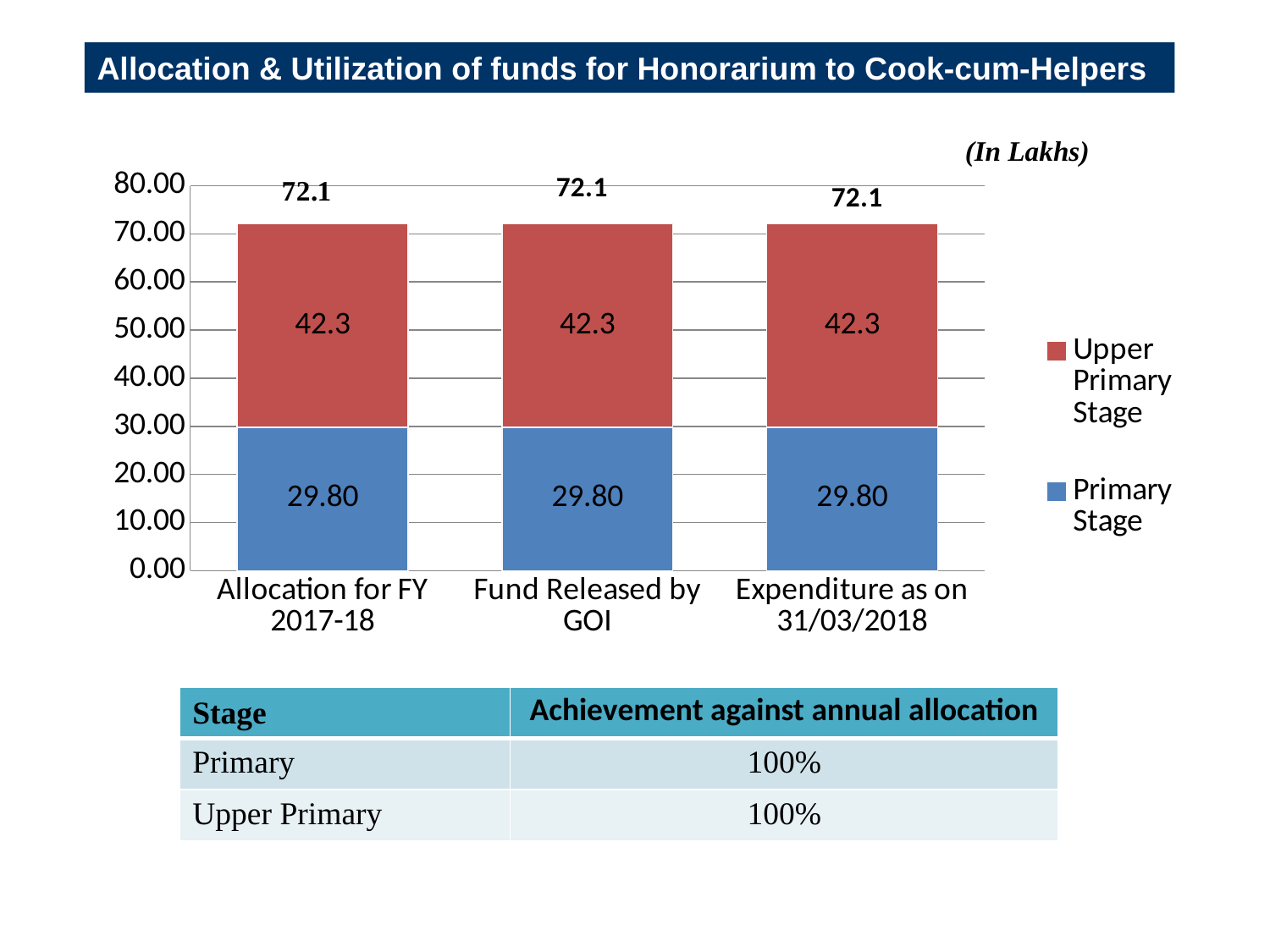
What is the total of the stacked bar for Expenditure as on 31/03/2018? 72.1 How many categories are shown on the x axis of the chart? 3 What is the difference between the Upper Primary Stage and Primary Stage values in the Fund Released by GOI bar? 12.5 What is the value for Primary Stage in the Allocation for FY 2017-18 bar? 29.80 How many series does the chart legend list? 2 Do the stacked bar totals rise, fall, or stay the same across the three categories? Stay the same What is the value for Upper Primary Stage in the Expenditure as on 31/03/2018 bar? 42.3 In the Allocation for FY 2017-18 bar, which is larger: Upper Primary Stage or Primary Stage? Upper Primary Stage What is the value for Upper Primary Stage in the Fund Released by GOI bar? 42.3 What kind of chart is shown on the slide? Stacked bar chart What is the total of the stacked bar for Allocation for FY 2017-18? 72.1 What unit is stated for the values in the chart? In Lakhs